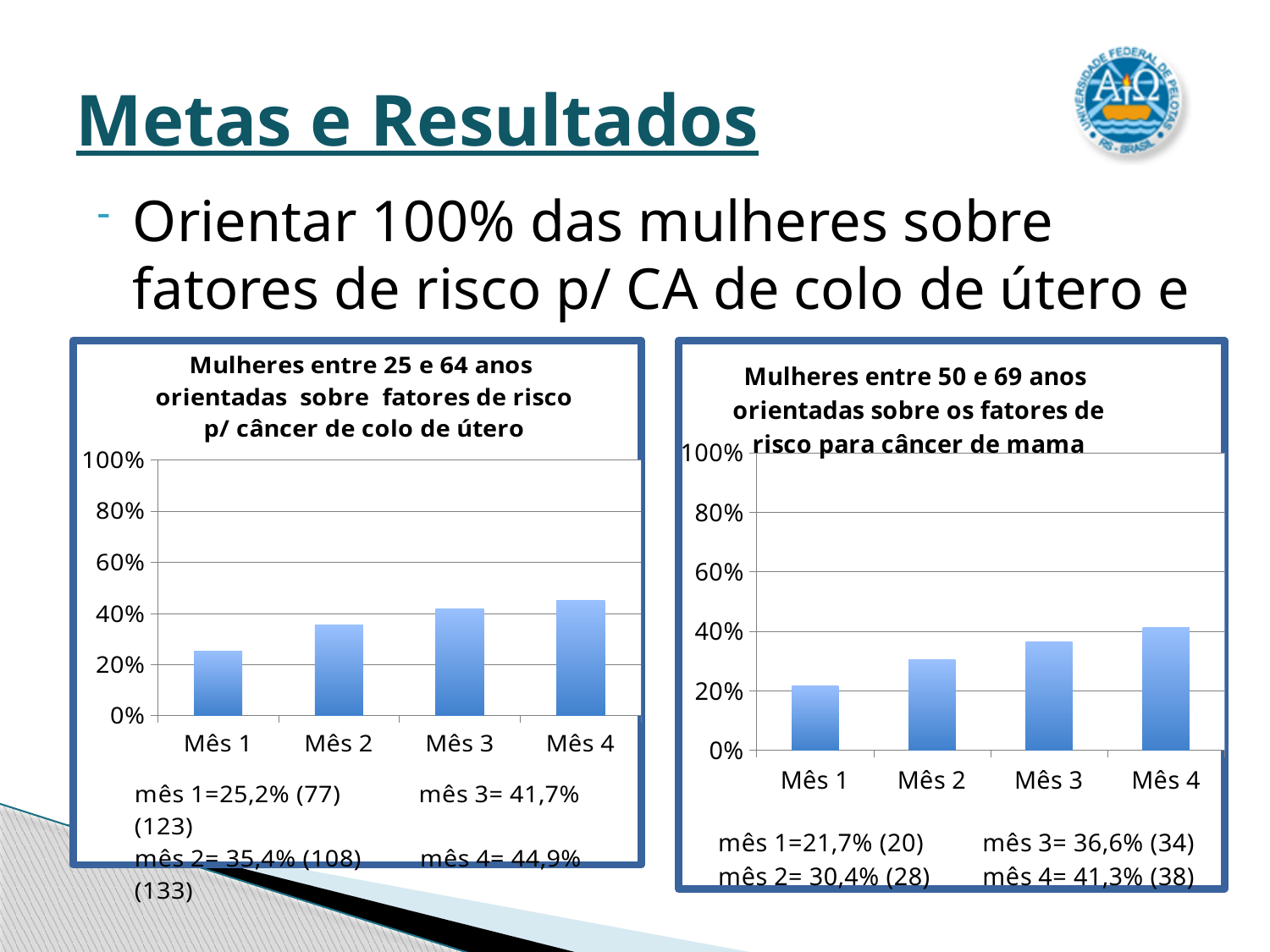
In the left chart (câncer de colo de útero), do the values rise or fall from Mês 1 to Mês 4? rise In the chart titled "Mulheres entre 25 e 64 anos orientadas sobre fatores de risco p/ câncer de colo de útero", what is the value for Mês 1? 25,2% How many months (categories) are shown in the left chart (câncer de colo de útero)? 4 What kind of chart is the right chart (câncer de mama)? bar chart In the chart titled "Mulheres entre 50 e 69 anos orientadas sobre os fatores de risco para câncer de mama", what is the value for Mês 4? 41,3% In the chart titled "Mulheres entre 25 e 64 anos orientadas sobre fatores de risco p/ câncer de colo de útero", what is the value for Mês 4? 44,9% In the left chart (câncer de colo de útero), which month has the highest value? Mês 4 In the chart titled "Mulheres entre 50 e 69 anos orientadas sobre os fatores de risco para câncer de mama", what is the value for Mês 2? 30,4% In the right chart (câncer de mama), which month has the lowest value? Mês 1 In the right chart (câncer de mama), is the value for Mês 3 greater or less than 40%? less In the left chart (câncer de colo de útero), what is the difference between the values for Mês 4 and Mês 1? 19,7% In the right chart (câncer de mama), what is the difference between the values for Mês 3 and Mês 2? 6,2%